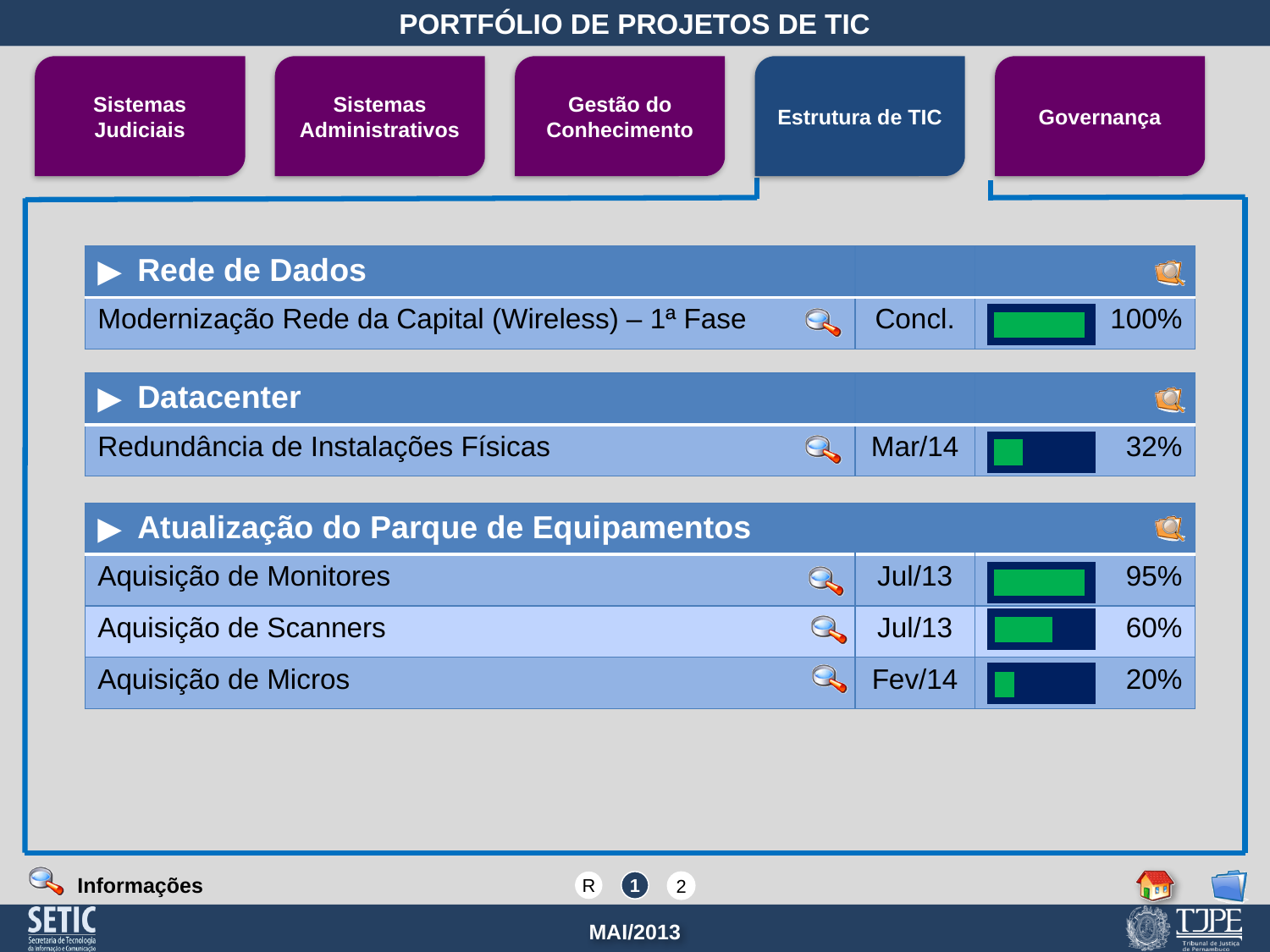
What completion percentage is shown for 'Modernização Rede da Capital (Wireless) – 1ª Fase'? 100% What status is shown next to 'Modernização Rede da Capital (Wireless) – 1ª Fase'? Concl. What is the difference in completion percentage between 'Aquisição de Monitores' and 'Aquisição de Micros'? 75% Which project has the lowest completion percentage on the slide? Aquisição de Micros What date is shown next to the project 'Aquisição de Micros'? Fev/14 What completion percentage is shown for 'Redundância de Instalações Físicas'? 32% How many projects with progress bars are listed on the slide? 5 Which has a higher completion percentage, 'Aquisição de Scanners' or 'Redundância de Instalações Físicas'? Aquisição de Scanners What completion percentage is shown for the project 'Aquisição de Scanners'? 60% What completion percentage is shown for 'Aquisição de Monitores'? 95% Which project has the highest completion percentage on the slide? Modernização Rede da Capital (Wireless) – 1ª Fase How many projects are listed under 'Atualização do Parque de Equipamentos'? 3